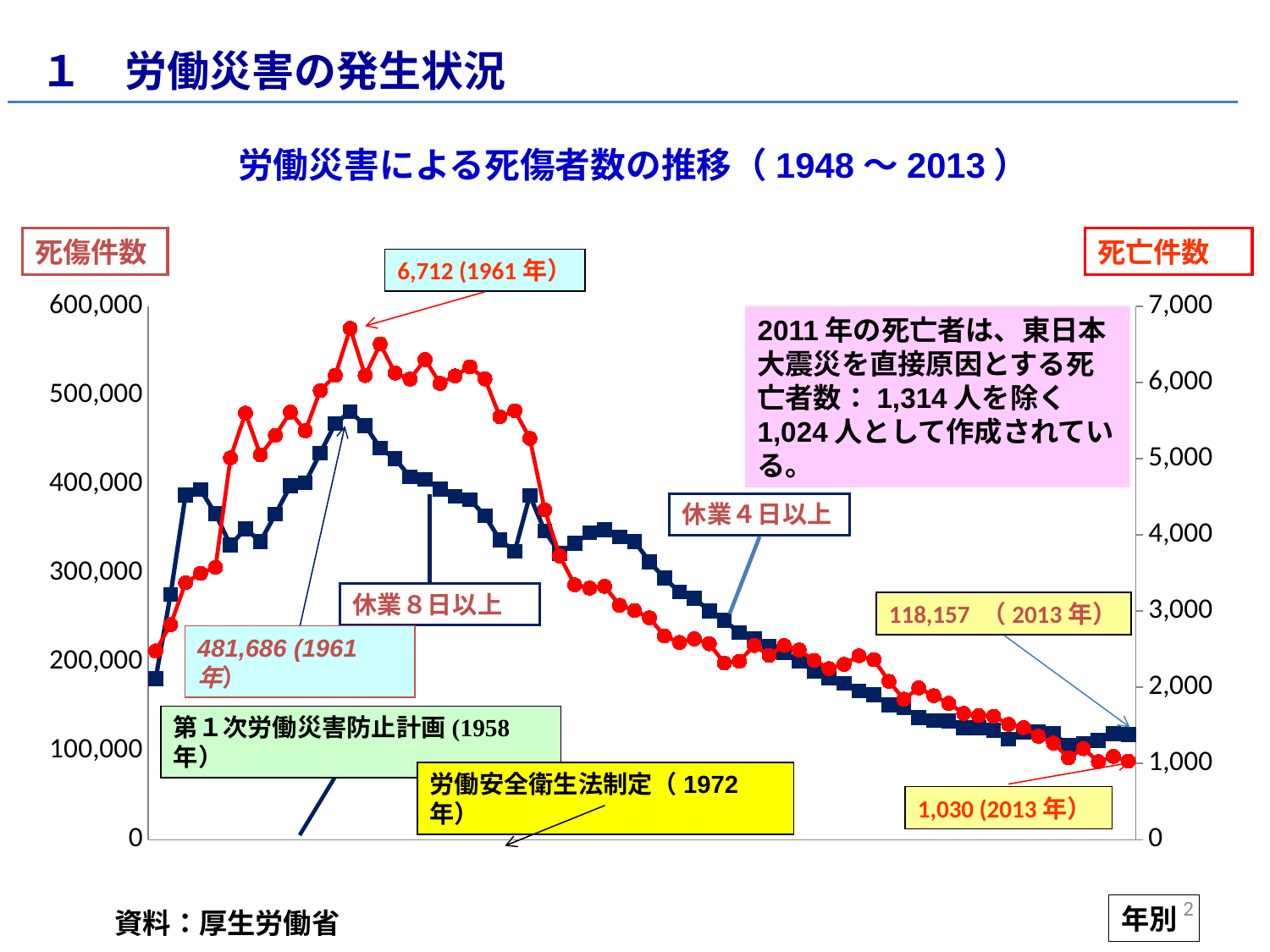
What kind of chart is shown on the slide? line chart What is the peak value of 死亡件数 shown in the annotation for 1961? 6,712 By how much did 死傷件数 fall from its 1961 value to its 2013 value? 363,529 What is the value of 死傷件数 annotated for 2013? 118,157 What is the maximum value shown on the right-hand axis (死亡件数)? 7,000 Do the 死亡件数 values rise or fall from 1961 to 2013? fall What is the value of 死亡件数 annotated for 2013? 1,030 Is the 死亡件数 value for 1961 greater or less than 6,000? greater Which is larger, 死傷件数 in 1961 or 死傷件数 in 2013? 1961 What is the title of the chart? 労働災害による死傷者数の推移（1948～2013） By how much did 死亡件数 fall from its 1961 value to its 2013 value? 5,682 What is the value of 死傷件数 annotated for 1961? 481,686